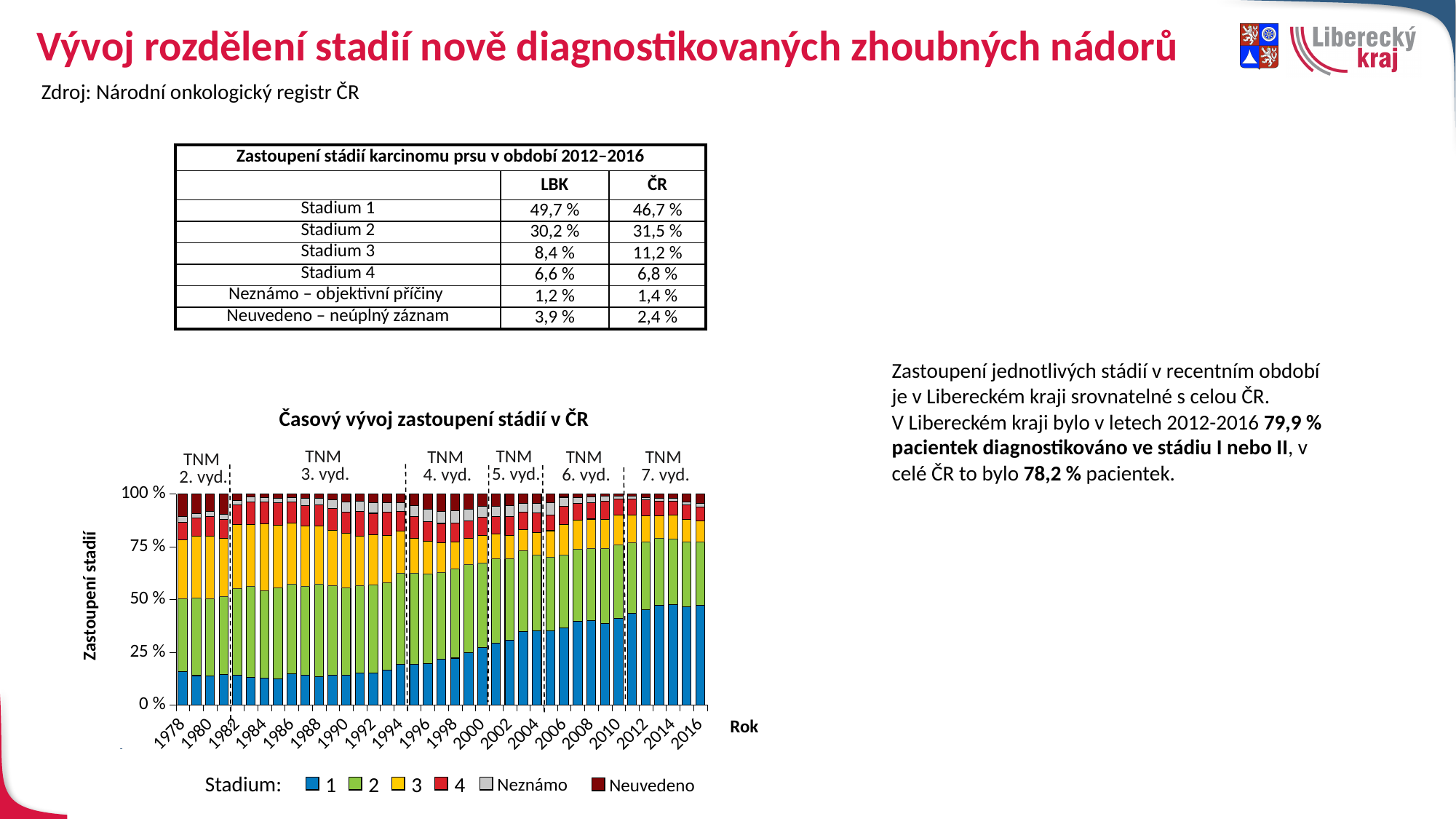
In the chart "Časový vývoj zastoupení stádií v ČR", is the share of Stadium 1 in 1978 greater or less than 25 %? less In the chart "Časový vývoj zastoupení stádií v ČR", is the share of Stadium 1 larger in 1978 or in 2016? 2016 What is the title of the chart on the slide? Časový vývoj zastoupení stádií v ČR What kind of chart is "Časový vývoj zastoupení stádií v ČR"? stacked bar chart In the chart "Časový vývoj zastoupení stádií v ČR", is the share of Stadium 1 in 2016 greater or less than 50 %? less In the chart "Časový vývoj zastoupení stádií v ČR", is the share of Stadium 1 in 2016 greater or less than 25 %? greater Which colour represents Stadium 1 in the chart "Časový vývoj zastoupení stádií v ČR"? blue What is the first year shown on the x axis of the chart "Časový vývoj zastoupení stádií v ČR"? 1978 What is the last year shown on the x axis of the chart "Časový vývoj zastoupení stádií v ČR"? 2016 How many series does the legend of the chart "Časový vývoj zastoupení stádií v ČR" list? 6 In the chart "Časový vývoj zastoupení stádií v ČR", does the share of Stadium 1 rise or fall from 1978 to 2016? rise